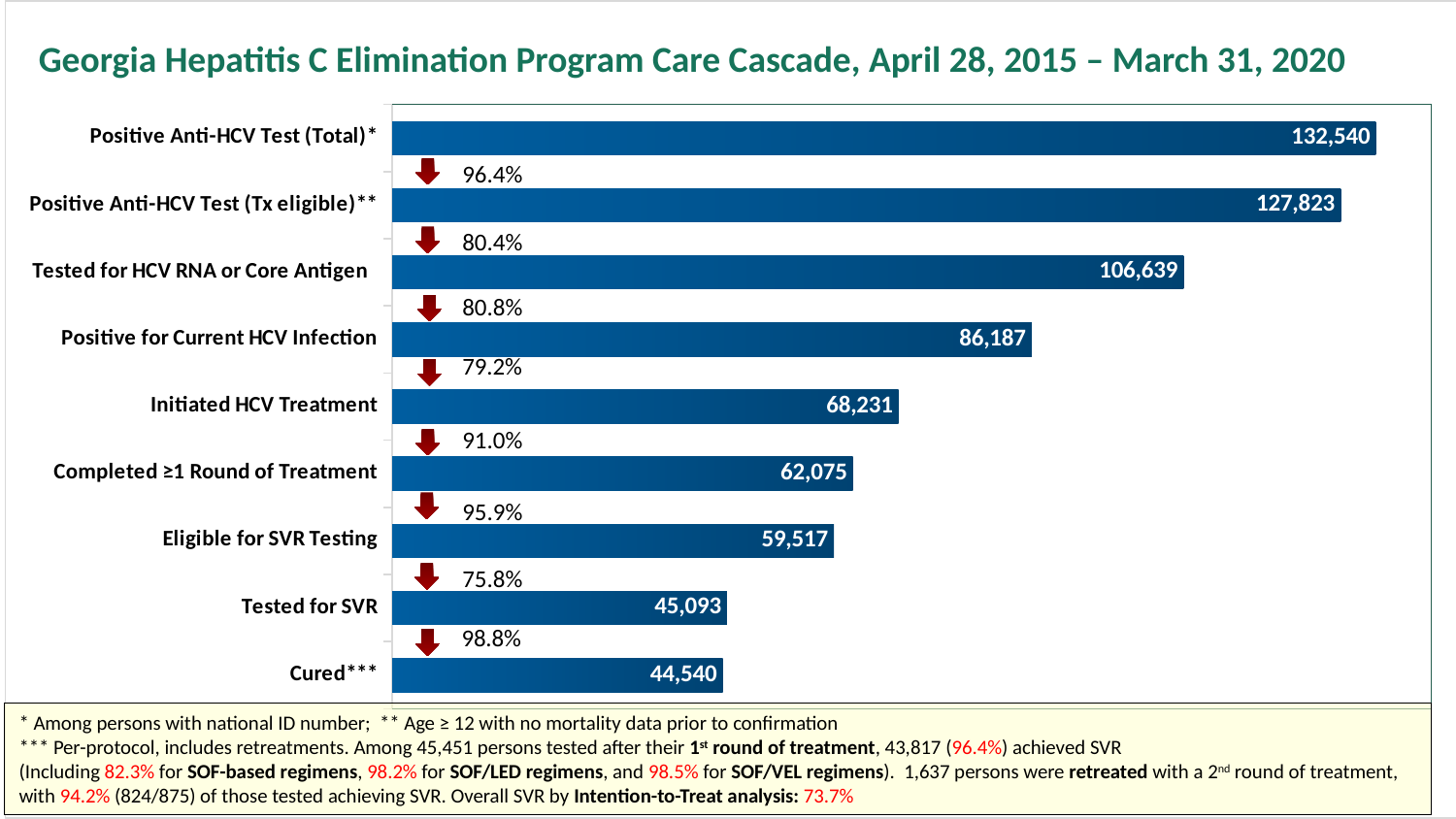
What is the value for Tested for HCV RNA or Core Antigen? 106,639 Which category has the highest value? Positive Anti-HCV Test (Total) Which is larger, Completed ≥1 Round of Treatment or Eligible for SVR Testing? Completed ≥1 Round of Treatment What is the value for Initiated HCV Treatment? 68,231 What kind of chart is this? Bar chart What percentage is shown between Tested for SVR and Cured? 98.8% How many categories are shown in the chart? 9 What is the difference between Tested for SVR and Cured? 553 What is the value for Positive Anti-HCV Test (Total)? 132,540 Which category has the lowest value? Cured What is the difference between Positive for Current HCV Infection and Initiated HCV Treatment? 17,956 What is the value for Cured? 44,540